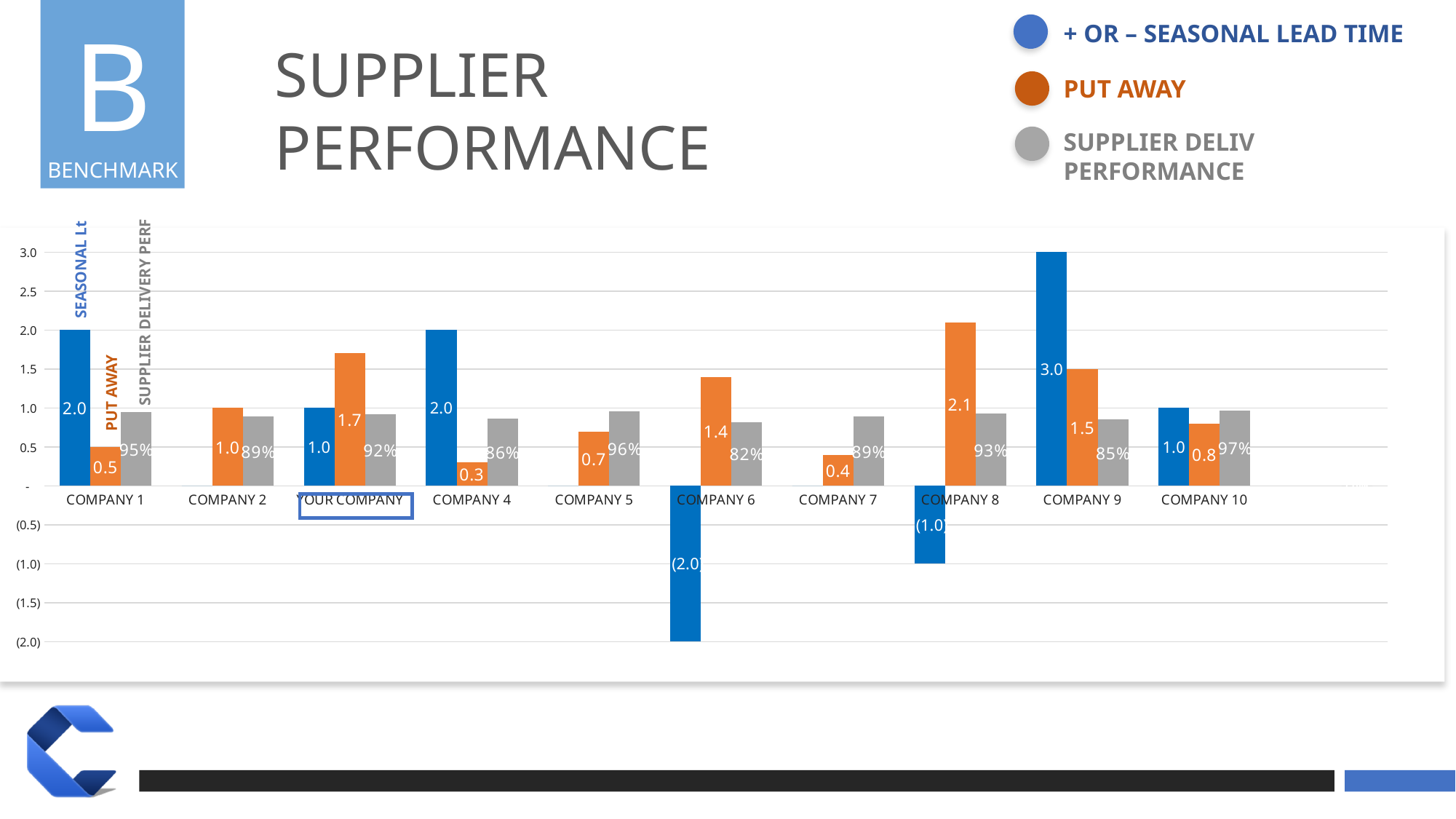
Which company has the highest PUT AWAY value? COMPANY 8 What is the difference between the PUT AWAY values of COMPANY 8 and COMPANY 4? 1.8 What is the SUPPLIER DELIVERY PERFORMANCE value for COMPANY 6? 82% How many companies are shown on the x axis of the chart? 10 What is the PUT AWAY value for YOUR COMPANY? 1.7 Which company has the highest SUPPLIER DELIVERY PERFORMANCE? COMPANY 10 What is the SEASONAL LEAD TIME value shown for COMPANY 6? (2.0) Which company has the highest SEASONAL LEAD TIME value? COMPANY 9 How many series does the legend list? 3 Which company has the lowest PUT AWAY value? COMPANY 4 What kind of chart is shown on the slide? Bar chart Which has the higher SUPPLIER DELIVERY PERFORMANCE, COMPANY 5 or COMPANY 9? COMPANY 5